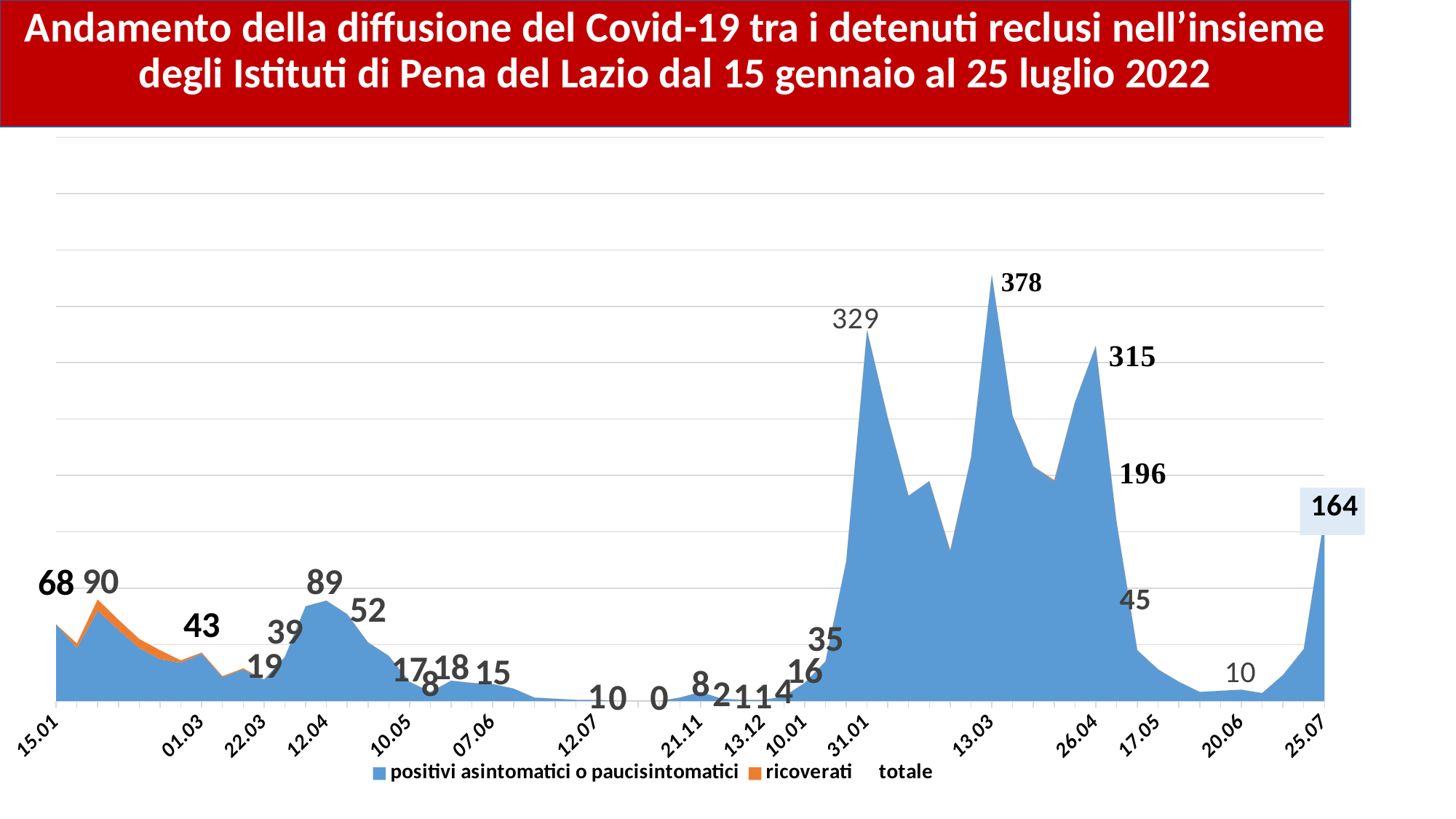
What type of chart is shown on the slide? area chart What is the difference between the peak value at 13.03 (378) and the value at 31.01 (329)? 49 How many series does the legend list? 3 What is the value labelled at 31.01? 329 Which series is shown in orange in the legend? ricoverati What is the value labelled at 25.07, the last point on the chart? 164 What is the lowest value labelled on the chart? 0 What is the value labelled at 15.01, the first point on the chart? 68 Which is larger, the value at 31.01 or the value at 26.04? 31.01 On which date does the chart reach its peak value of 378? 13.03 What is the highest value labelled on the chart? 378 What is the value labelled at 26.04? 315